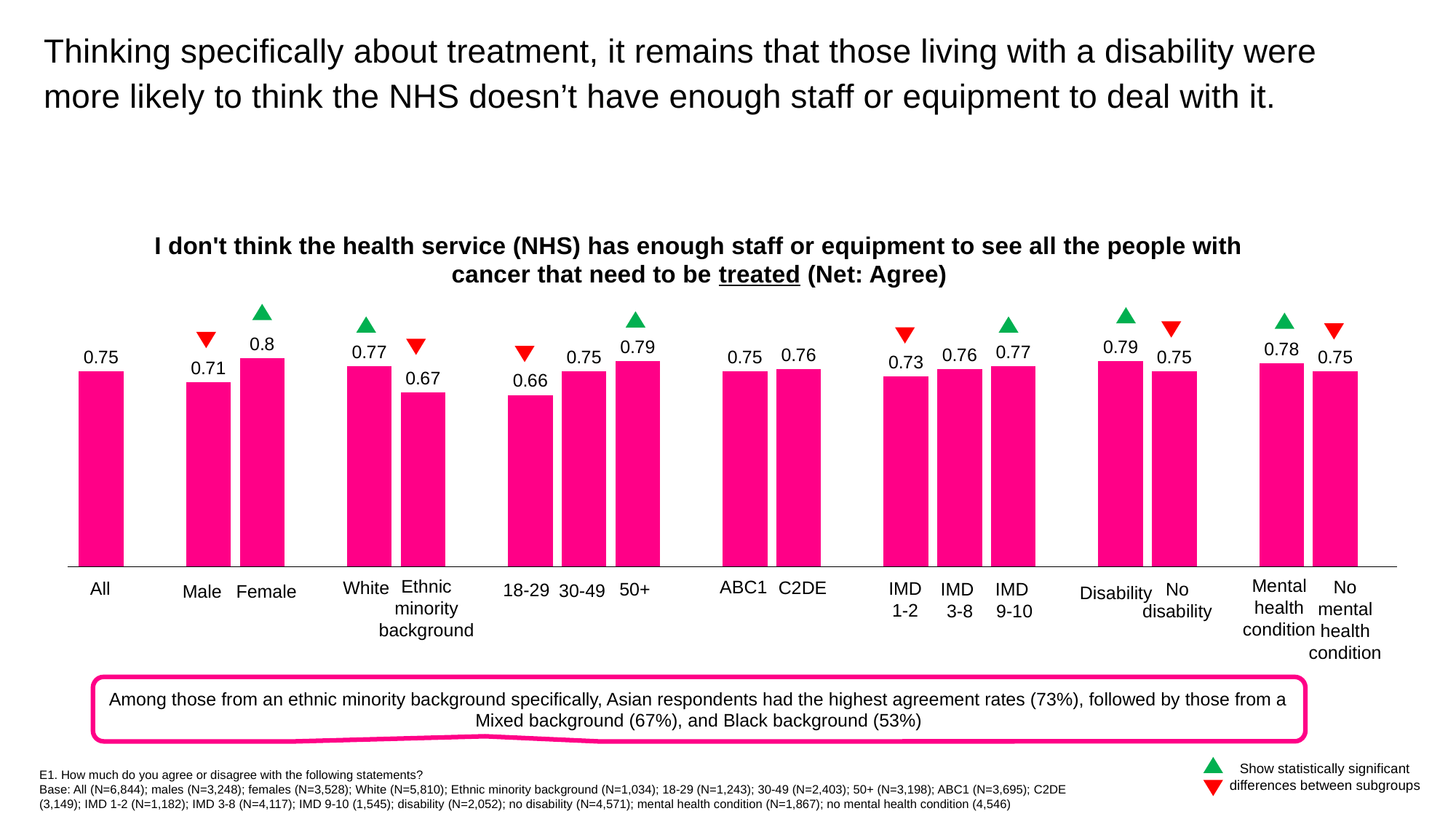
Do the values rise or fall across the age groups from 18-29 to 50+? Rise Which category has the highest value? Female Which category has the lowest value? 18-29 What is the value for Ethnic minority background? 0.67 What type of chart is shown on the slide? Bar chart What is the value for Female? 0.8 Which is larger, the value for White or the value for Ethnic minority background? White How many bars are plotted in the chart? 17 What is the difference between the values for Disability and No disability? 0.04 What is the value for Disability? 0.79 What is the difference between the values for Female and Male? 0.09 What is the value for the 18-29 age group? 0.66